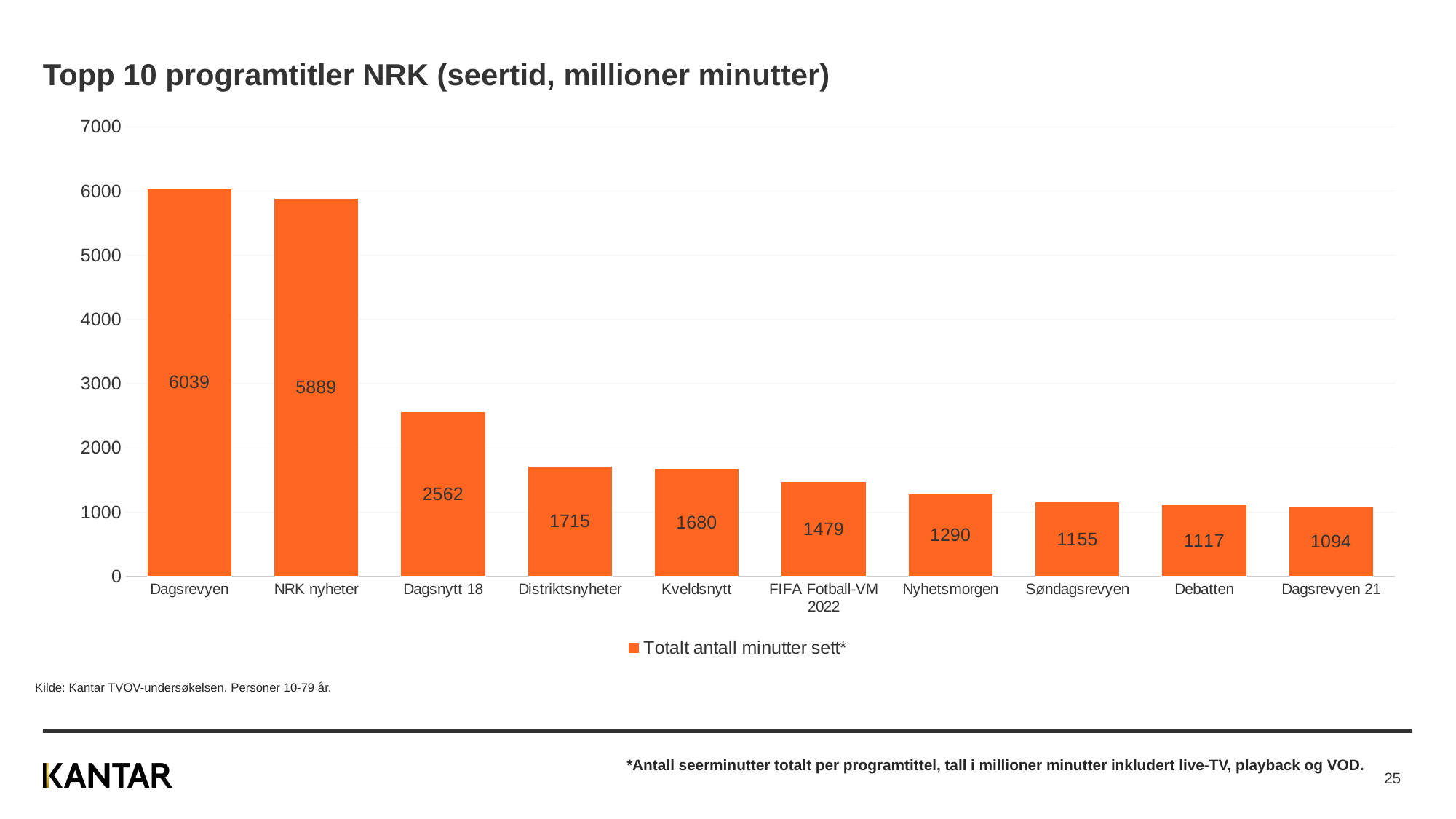
What is the difference between the values for Dagsnytt 18 and Distriktsnyheter? 847 Which is larger, the value for Nyhetsmorgen or the value for Søndagsrevyen? Nyhetsmorgen What kind of chart is shown on the slide? Bar chart What is the legend entry for the series shown? Totalt antall minutter sett* What is the difference between the values for Dagsrevyen and NRK nyheter? 150 How many program titles are shown on the chart? 10 Which program title has the highest value? Dagsrevyen What is the value for FIFA Fotball-VM 2022? 1479 How many series does the legend list? 1 What is the value for Kveldsnytt? 1680 What is the value for Dagsrevyen? 6039 Which program title has the lowest value? Dagsrevyen 21